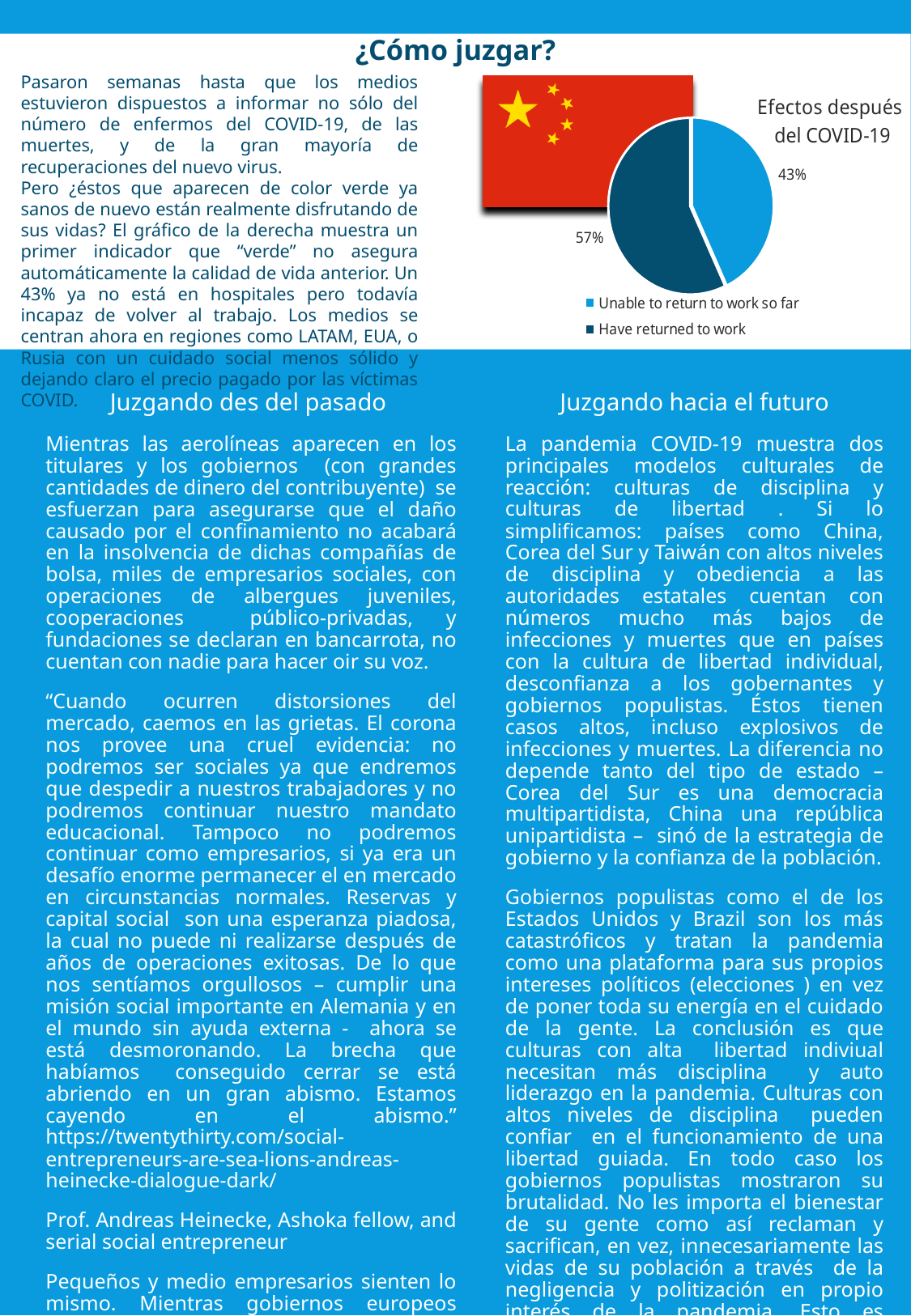
What is the difference in percentage points between the "Have returned to work" slice and the "Unable to return to work so far" slice? 14 How many entries does the chart legend list? 2 How many slices does the pie chart have? 2 What kind of chart is shown on the slide? pie chart Is the share for "Have returned to work" greater or less than 50%? greater Which slice of the pie is the smallest? Unable to return to work so far What is the title of the chart? Efectos después del COVID-19 Which slice of the pie is the largest? Have returned to work Which legend entry is shown in the darker blue colour? Have returned to work What share of the pie is labelled "Unable to return to work so far"? 43% What share of the pie is labelled "Have returned to work"? 57% Which is larger: the share that has returned to work or the share unable to return to work so far? Have returned to work